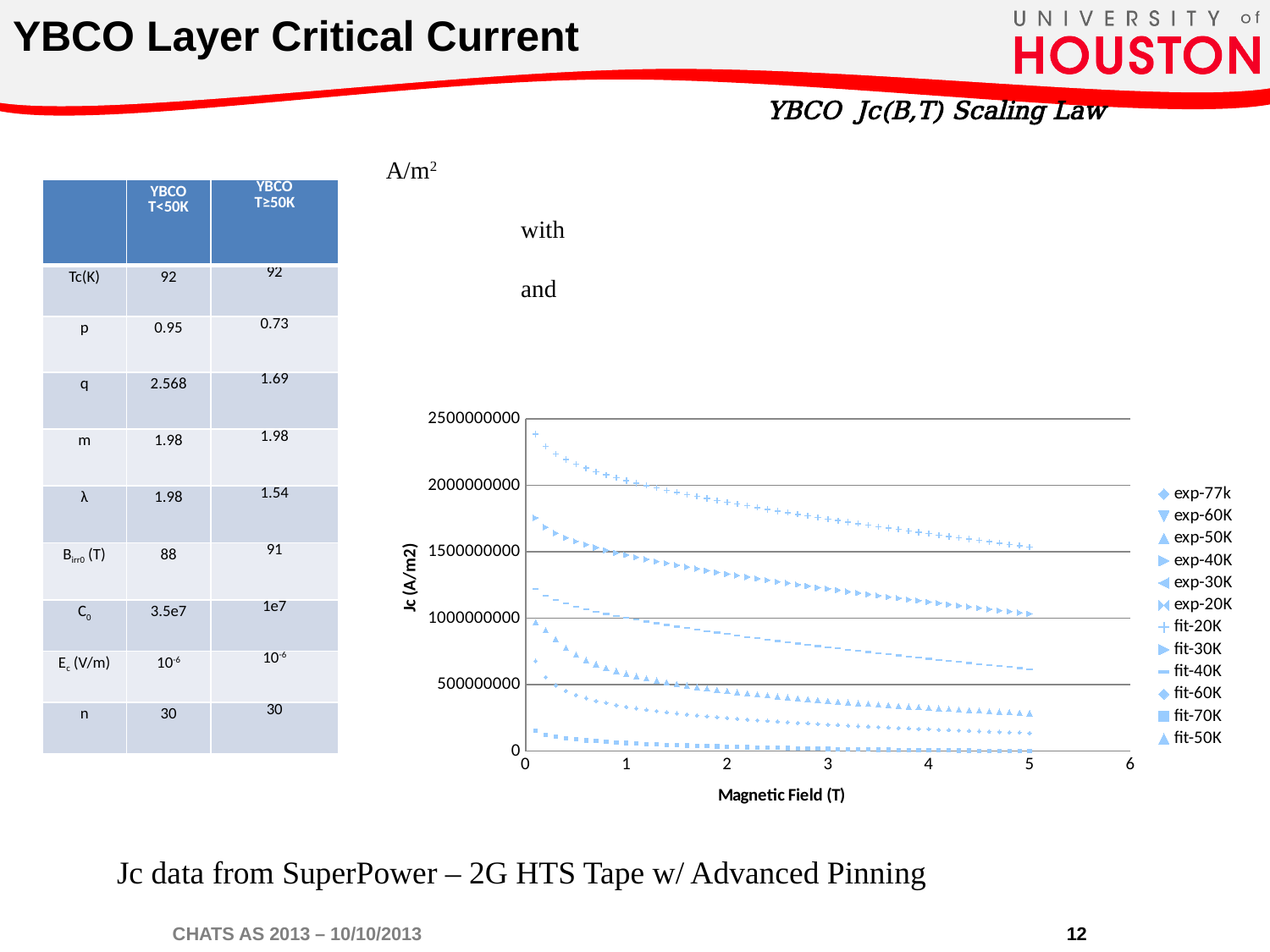
Is the value of the fit-20K series (plus markers) at the lowest magnetic field greater or less than 2000000000? greater What is the title of the chart's y axis? Jc (A/m2) Is the value of the fit-70K series (square markers) at a magnetic field of 1 T greater or less than 500000000? less Is the value of the fit-40K series (dashed line) at the lowest magnetic field greater or less than 1000000000? greater What is the title of the chart's x axis? Magnetic Field (T) Which series has the highest Jc values across the plotted magnetic field range? fit-20K What is the highest tick value shown on the chart's y axis? 2500000000 As the magnetic field increases along the x axis, do the Jc values rise or fall? fall Which series has the lowest Jc values across the plotted magnetic field range? fit-70K How many series does the chart legend list? 12 What kind of chart is shown on the slide? scatter chart